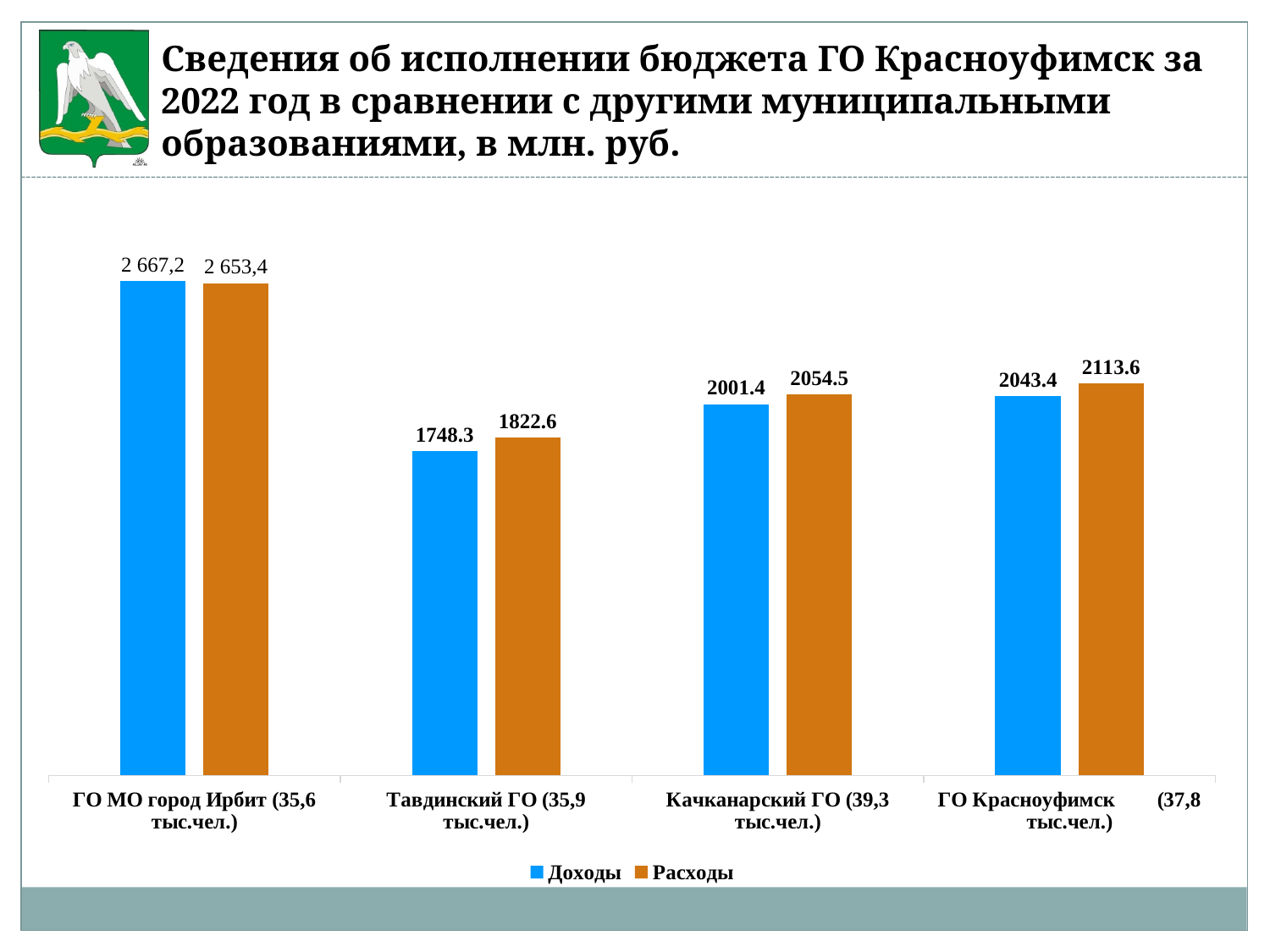
What is the value of Расходы for ГО Красноуфимск? 2113.6 What is the value of Доходы for Тавдинский ГО? 1748.3 Which is larger for Качканарский ГО, Доходы or Расходы? Расходы How many municipalities (categories) are shown on the chart? 4 What type of chart is shown on the slide? Bar chart Which municipality has the highest Доходы value? ГО МО город Ирбит Which municipality has the lowest Расходы value? Тавдинский ГО What is the value of Расходы for Качканарский ГО? 2054.5 What is the difference between Расходы and Доходы for ГО Красноуфимск? 70.2 What is the value of Доходы for ГО МО город Ирбит? 2 667,2 How many series does the legend list? 2 Which series is shown in orange in the legend? Расходы